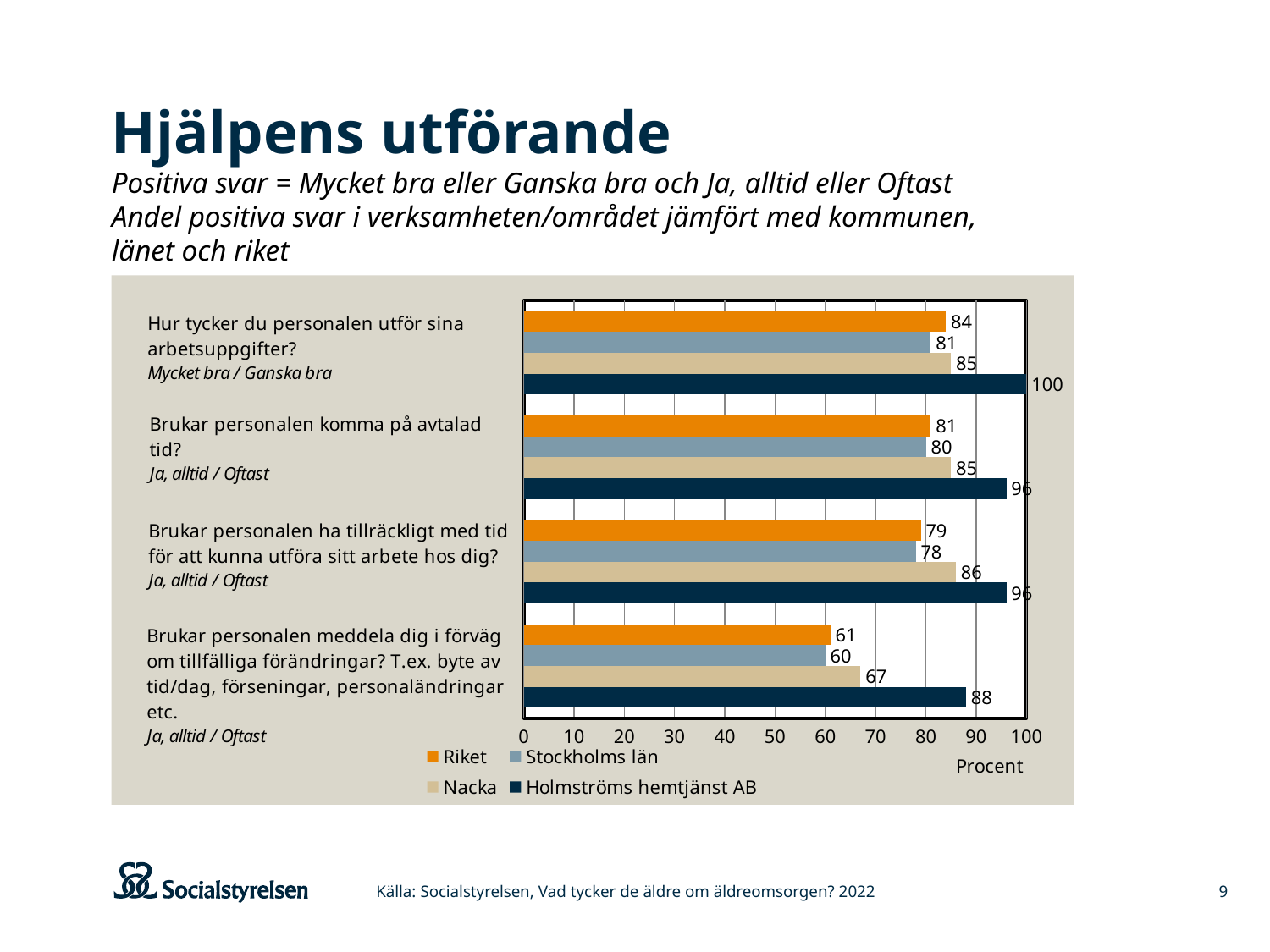
What is the value for Stockholms län on the question "Brukar personalen meddela dig i förväg om tillfälliga förändringar?"? 60 Which series has the highest value on the question "Brukar personalen meddela dig i förväg om tillfälliga förändringar?"? Holmströms hemtjänst AB What is the value for Nacka on the question "Brukar personalen komma på avtalad tid?"? 85 How many series does the legend list? 4 What is the difference between Holmströms hemtjänst AB and Riket on the question "Brukar personalen meddela dig i förväg om tillfälliga förändringar?"? 27 What is the label of the horizontal axis of the chart? Procent What kind of chart is shown on the slide? Bar chart What is the value for Riket on the question "Brukar personalen ha tillräckligt med tid för att kunna utföra sitt arbete hos dig?"? 79 What is the value for Holmströms hemtjänst AB on the question "Hur tycker du personalen utför sina arbetsuppgifter?"? 100 How many questions (categories) are shown in the chart? 4 Which series has the lowest value on the question "Brukar personalen ha tillräckligt med tid för att kunna utföra sitt arbete hos dig?"? Stockholms län Which is larger on the question "Brukar personalen komma på avtalad tid?": Nacka or Riket? Nacka